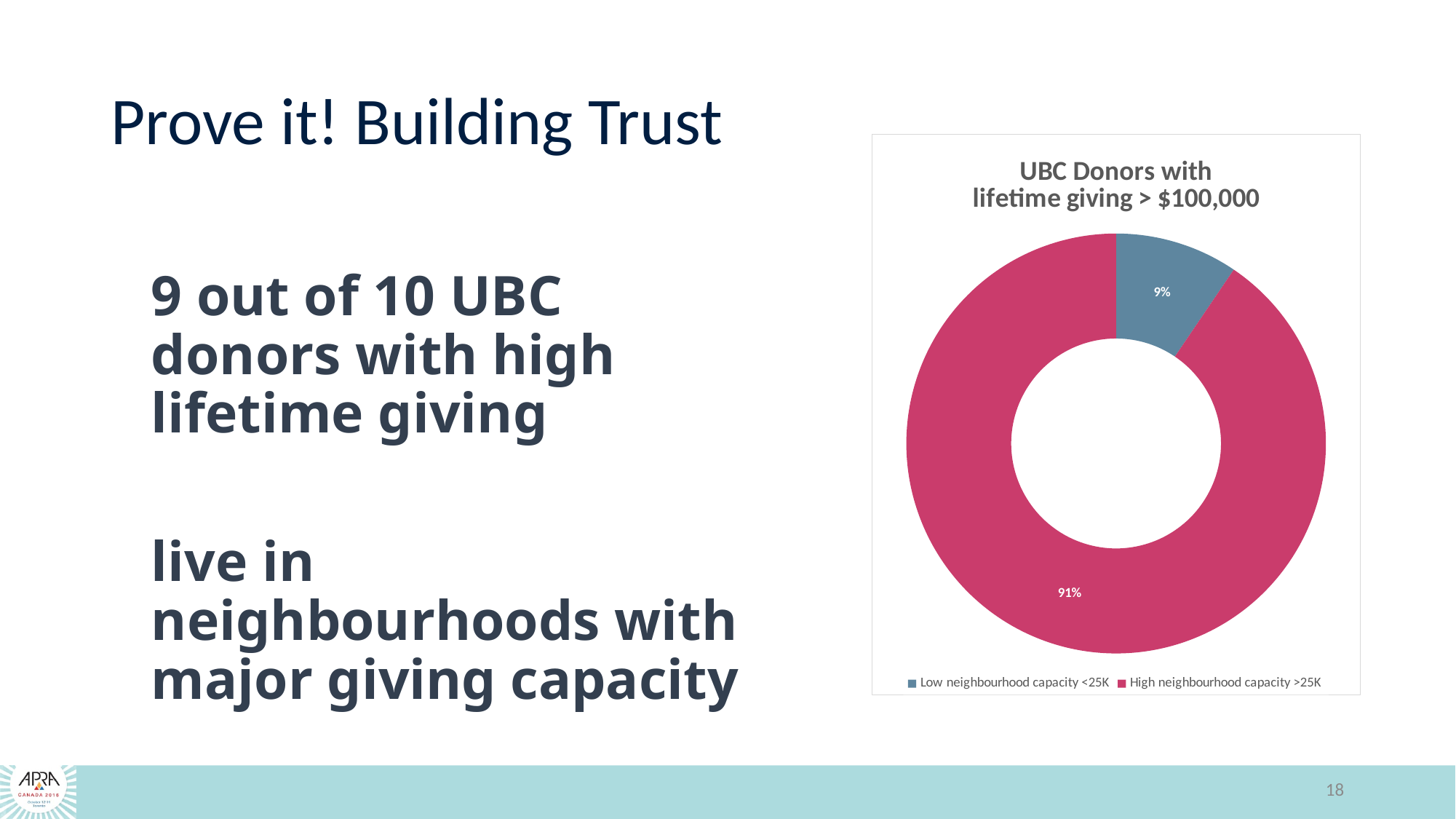
What percentage of the donut chart is labelled 'Low neighbourhood capacity <25K'? 9% What share of the chart does the High neighbourhood capacity >25K slice represent? 91% What colour is the slice for Low neighbourhood capacity <25K? Blue What type of chart is shown on the slide? Donut (pie) chart How many categories does the chart show? 2 What is the difference in percentage points between the High neighbourhood capacity and Low neighbourhood capacity slices? 82 How many entries does the legend list? 2 What percentage of the donut chart is labelled 'High neighbourhood capacity >25K'? 91% What is the title of the chart? UBC Donors with lifetime giving > $100,000 Which category has the largest share of the chart? High neighbourhood capacity >25K Which category has the smallest share of the chart? Low neighbourhood capacity <25K Which slice is larger: Low neighbourhood capacity <25K or High neighbourhood capacity >25K? High neighbourhood capacity >25K